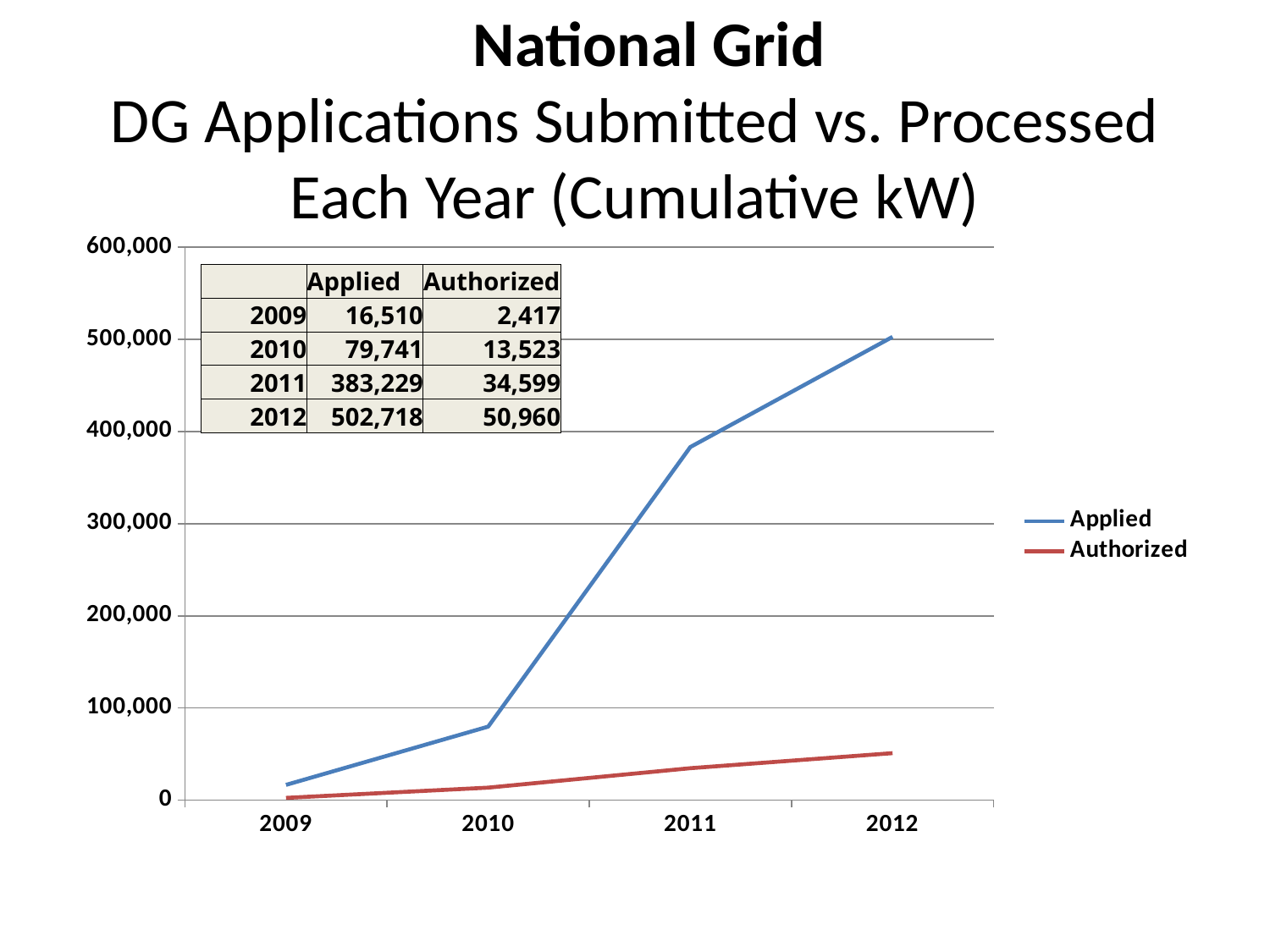
What type of chart is shown on the slide? line chart What colour is the Authorized line? red Does the Applied series rise or fall from 2009 to 2012? rise What is the Applied value for 2012? 502,718 In which year is the Authorized value lowest? 2009 Which is larger in 2011, Applied or Authorized? Applied How many years are plotted on the x axis? 4 How many series does the legend list? 2 What is the Applied value for 2011? 383,229 What is the difference between Applied and Authorized in 2012? 451,758 What is the Authorized value for 2010? 13,523 In which year is the Applied value highest? 2012